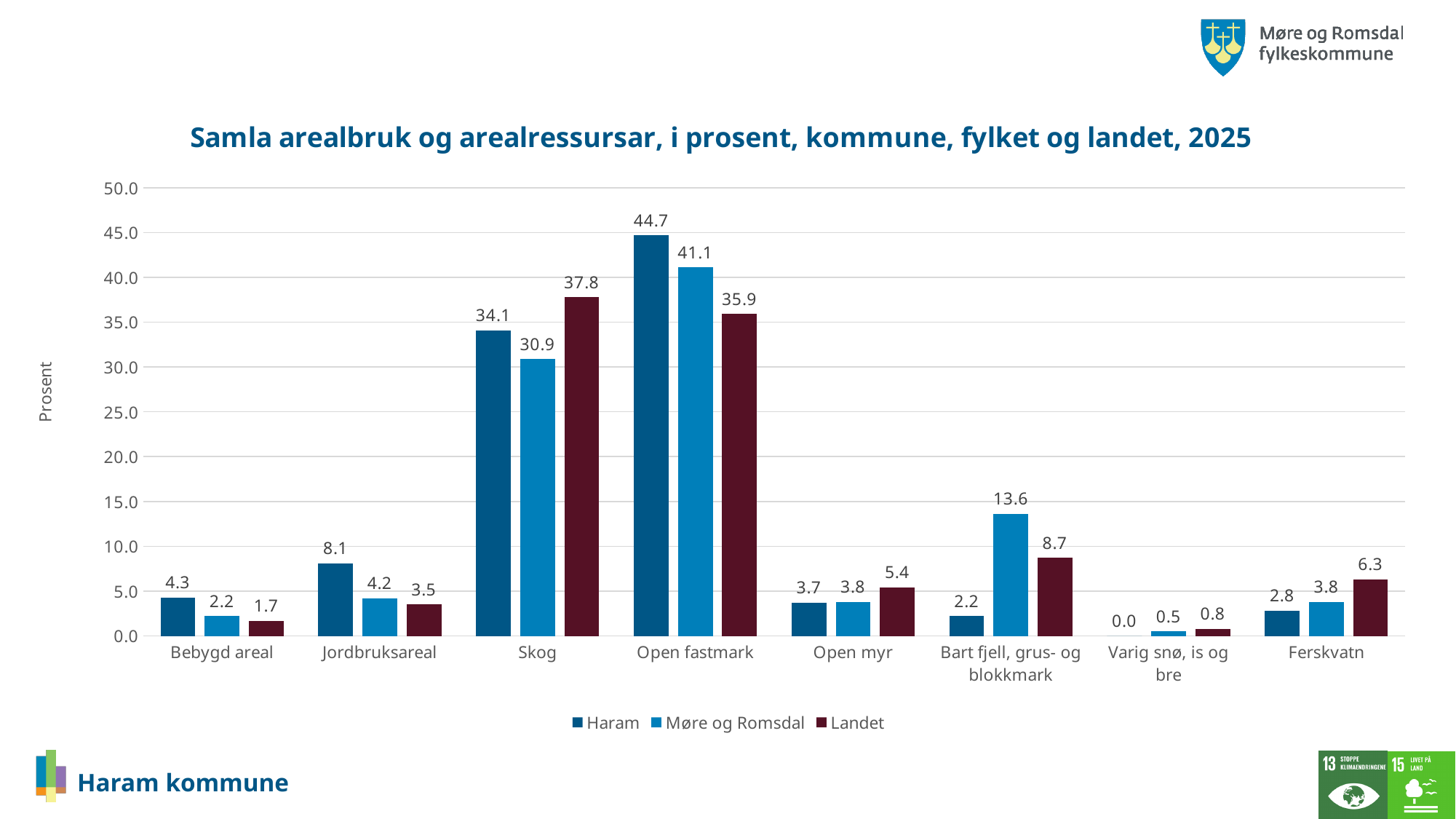
What kind of chart is shown on the slide? Bar chart How many series does the legend list? 3 Which is larger for Skog: the value for Haram or the value for Landet? Landet What is the value for Møre og Romsdal in the Bart fjell, grus- og blokkmark category? 13.6 Which category has the lowest value for Landet? Varig snø, is og bre How many categories are shown on the x axis? 8 What is the value for Landet in the Open fastmark category? 35.9 What is the label on the y axis? Prosent Which category has the highest value for Haram? Open fastmark What is the value for Haram in the Skog category? 34.1 What is the title of the chart? Samla arealbruk og arealressursar, i prosent, kommune, fylket og landet, 2025 What is the difference between the Haram and Landet values for Jordbruksareal? 4.6